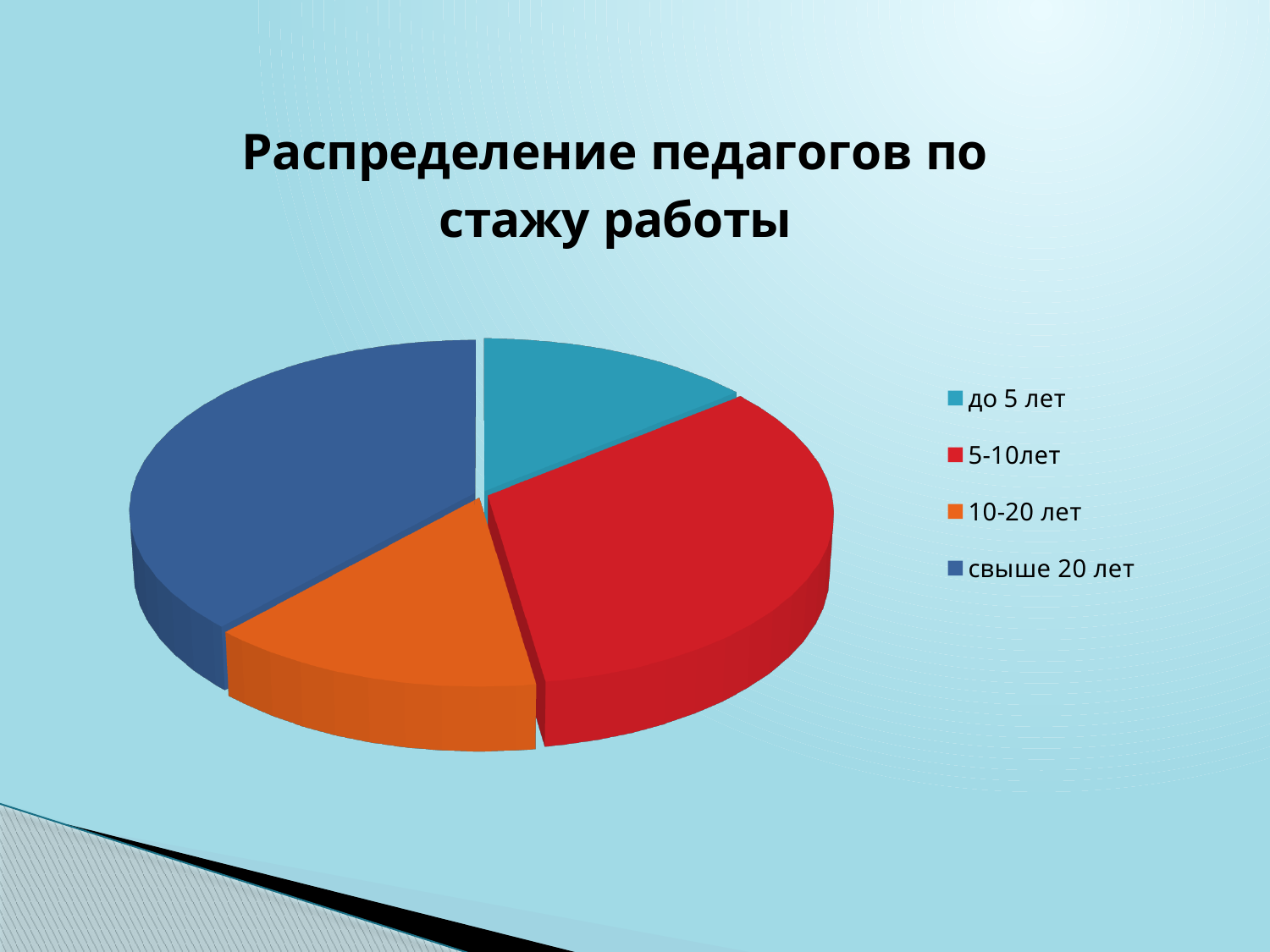
Which slice is larger: свыше 20 лет or 10-20 лет? свыше 20 лет Which category has the largest slice of the pie? свыше 20 лет Which slice is larger: 5-10лет or до 5 лет? 5-10лет Which slice is larger: 5-10лет or 10-20 лет? 5-10лет How many categories (slices) does the pie chart have? 4 What colour is the slice for 10-20 лет? orange What kind of chart is shown on the slide? pie chart What is the title of the chart? Распределение педагогов по стажу работы How many entries does the legend list? 4